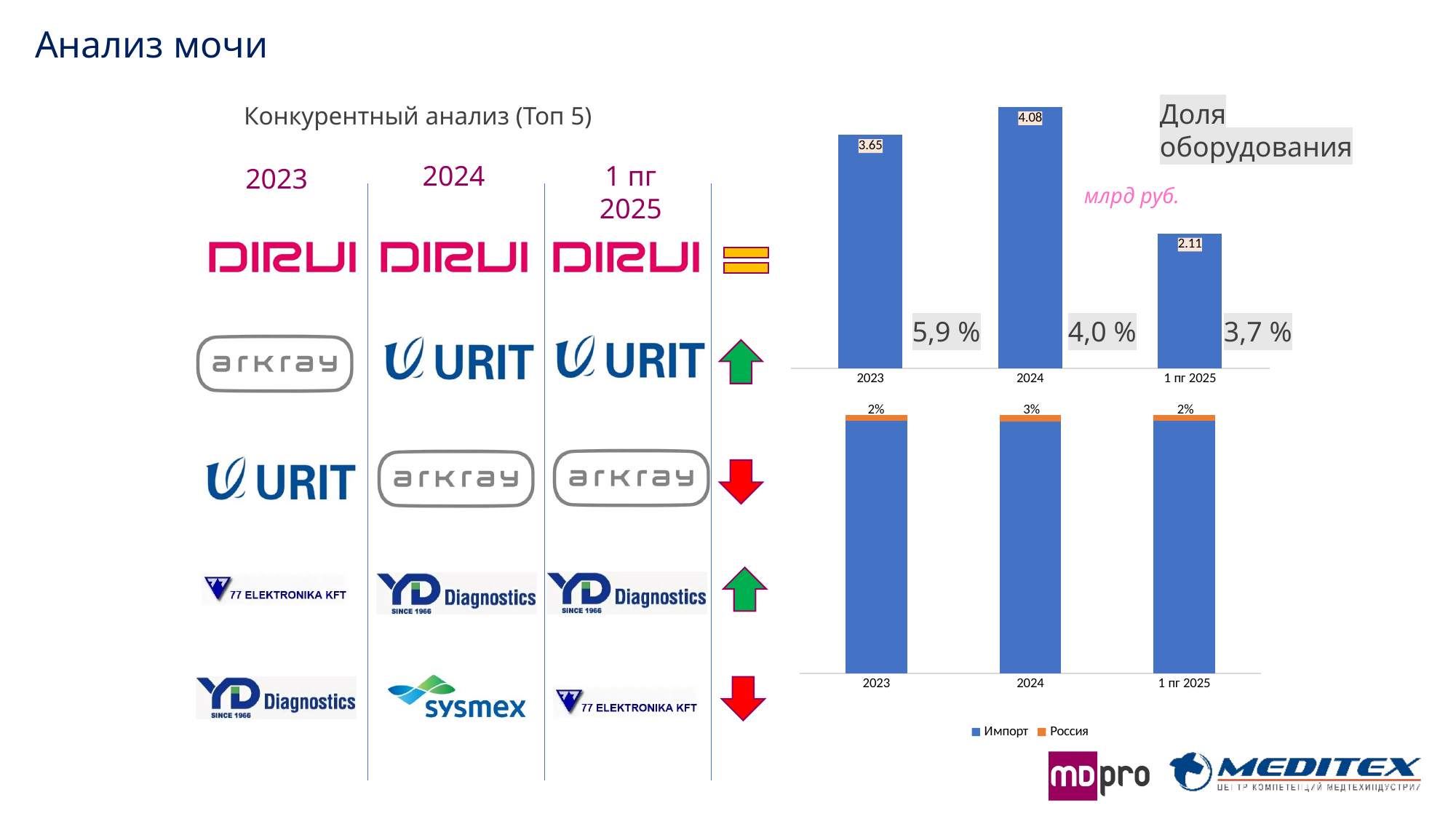
In the top bar chart on the right, what is the difference between the 2024 and 2023 values? 0.43 In the top bar chart on the right, which category has the lowest value? 1 пг 2025 In the bottom stacked bar chart on the right, what is the Россия share for 2023? 2% In the top bar chart on the right, which is larger: the value for 2023 or the value for 1 пг 2025? 2023 In the bottom stacked bar chart on the right, what is the Россия share for 2024? 3% In the top bar chart on the right, what is the value for 2024? 4.08 What kind of chart is the bottom chart on the right? Stacked bar chart In the bottom stacked bar chart on the right, how many series does the legend list? 2 In the top bar chart on the right, what is the value for 2023? 3.65 In the top bar chart on the right, how many categories are shown on the x axis? 3 In the top bar chart on the right, what is the value for 1 пг 2025? 2.11 In the top bar chart on the right, which category has the highest value? 2024